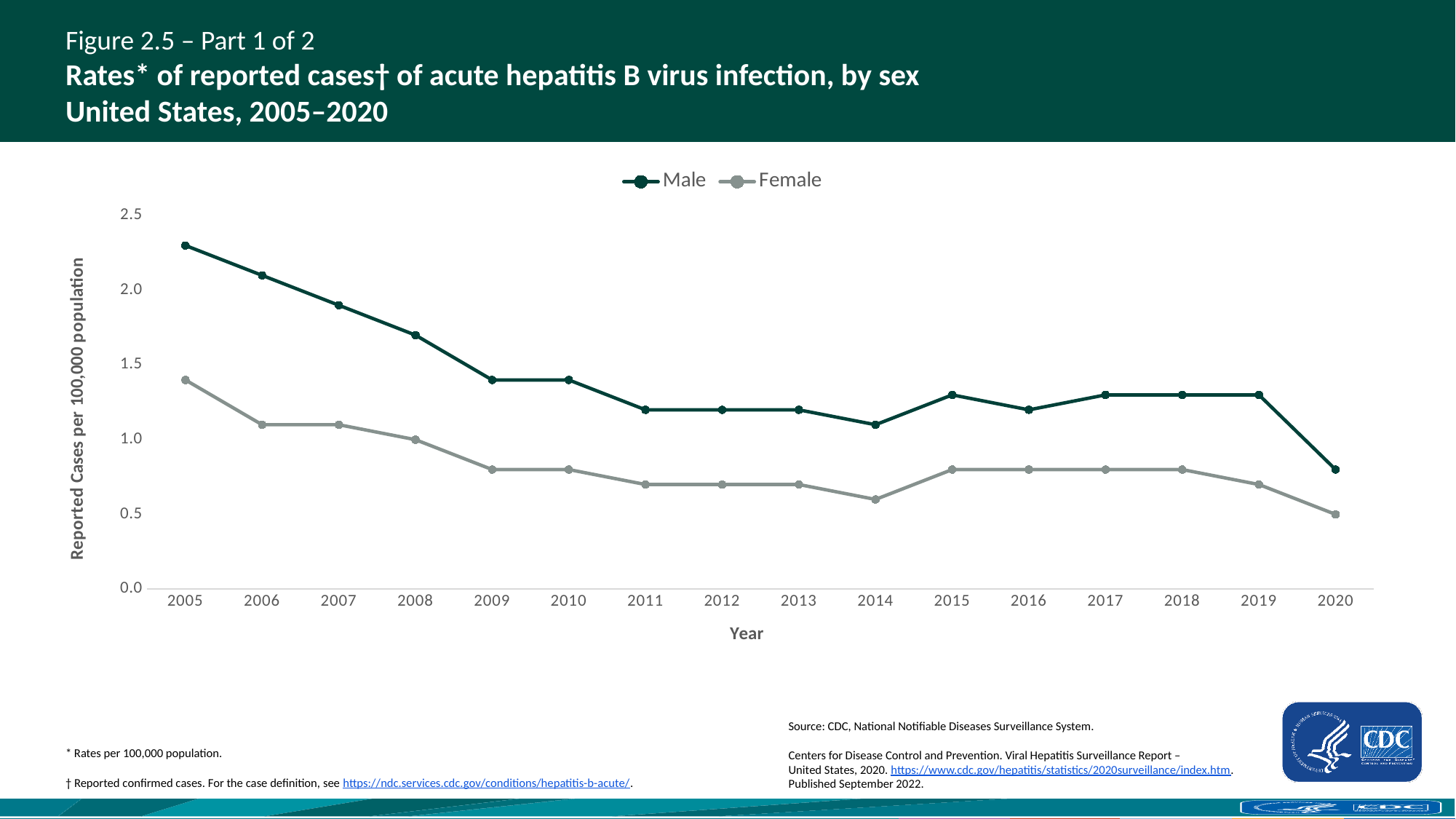
In which year is the Male rate highest? 2005 In which year is the Male rate lowest? 2020 Is the Male rate in 2020 greater or less than 1.0? less How many series does the legend list? 2 Which series has the higher rate in 2010, Male or Female? Male In which year is the Female rate lowest? 2020 What kind of chart is shown on the slide? line chart Is the Female rate in 2009 greater or less than 1.0? less How many years are plotted along the x axis? 16 Overall, do the Male rates rise or fall from 2005 to 2020? fall Is the Male rate in 2005 greater or less than 2.0? greater What is the label on the y axis? Reported Cases per 100,000 population